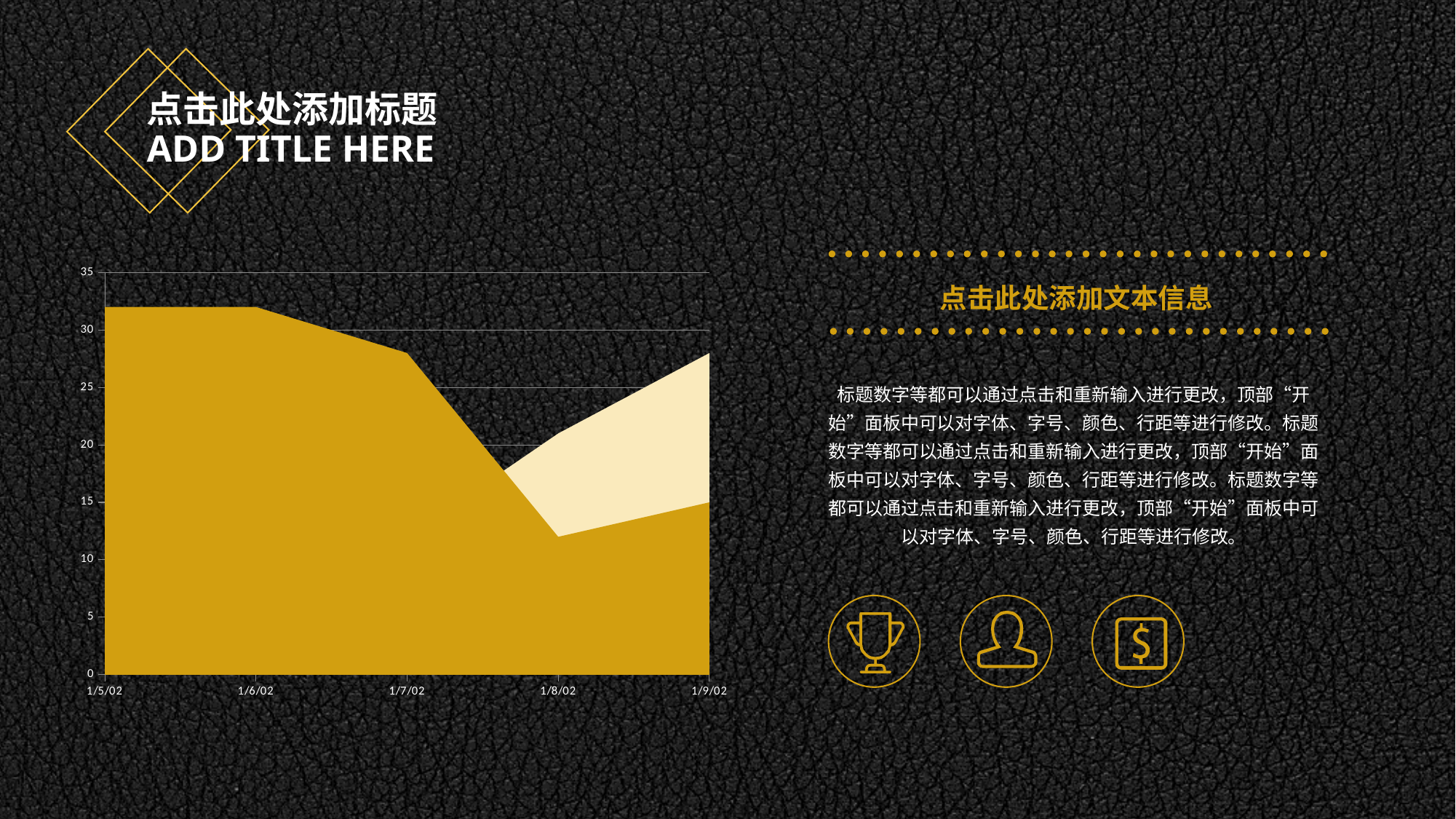
Is the value of the dark gold area at 1/8/02 greater or less than 15? less How many dates are labelled along the x axis of the chart? 5 Does the dark gold area rise or fall from 1/6/02 to 1/8/02? Fall What is the highest value shown on the y axis of the chart? 35 At 1/9/02, which area reaches higher: the dark gold area or the light cream area? The light cream area What is the first date label on the x axis of the chart? 1/5/02 Is the value of the light cream area at 1/9/02 greater or less than 25? greater Is the value of the dark gold area at 1/7/02 greater or less than 25? greater At which date does the dark gold area reach its lowest value? 1/8/02 Which is larger for the dark gold area: the value at 1/6/02 or the value at 1/8/02? 1/6/02 What kind of chart is shown on the slide? Area chart